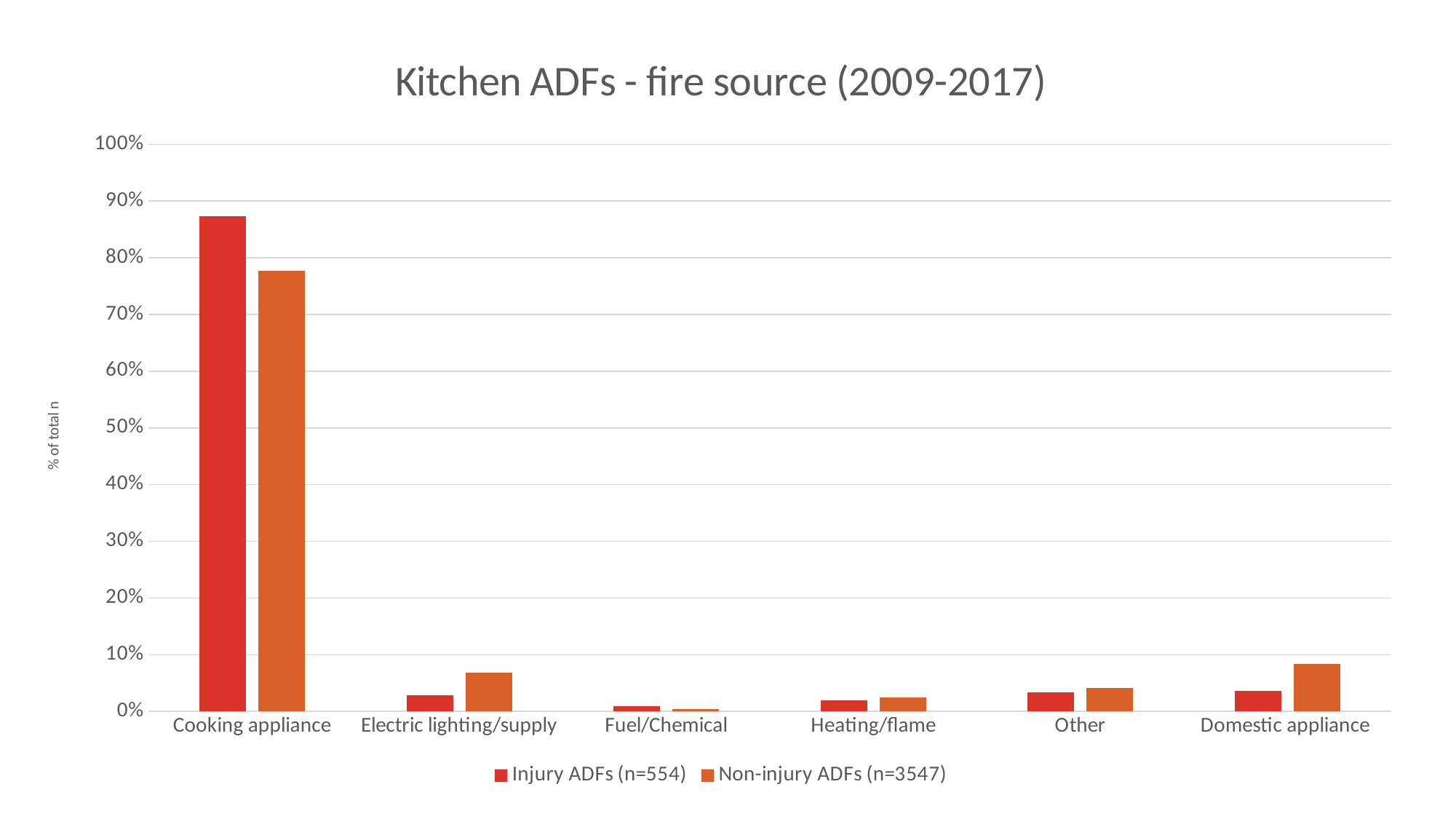
How many fire source categories are shown on the x axis? 6 Which fire source category has the lowest value for Non-injury ADFs (n=3547)? Fuel/Chemical For Domestic appliance, which series has the larger value: Injury ADFs (n=554) or Non-injury ADFs (n=3547)? Non-injury ADFs (n=3547) Is the Non-injury ADFs (n=3547) value for Cooking appliance greater or less than 80%? less What is the title of the chart? Kitchen ADFs - fire source (2009-2017) For Cooking appliance, which series has the larger value: Injury ADFs (n=554) or Non-injury ADFs (n=3547)? Injury ADFs (n=554) For Electric lighting/supply, which series has the larger value: Injury ADFs (n=554) or Non-injury ADFs (n=3547)? Non-injury ADFs (n=3547) How many series does the legend list? 2 Which fire source category has the highest value for Injury ADFs (n=554)? Cooking appliance Which fire source category has the highest value for Non-injury ADFs (n=3547)? Cooking appliance What kind of chart is shown on the slide? Bar chart Is the Injury ADFs (n=554) value for Cooking appliance greater or less than 80%? greater